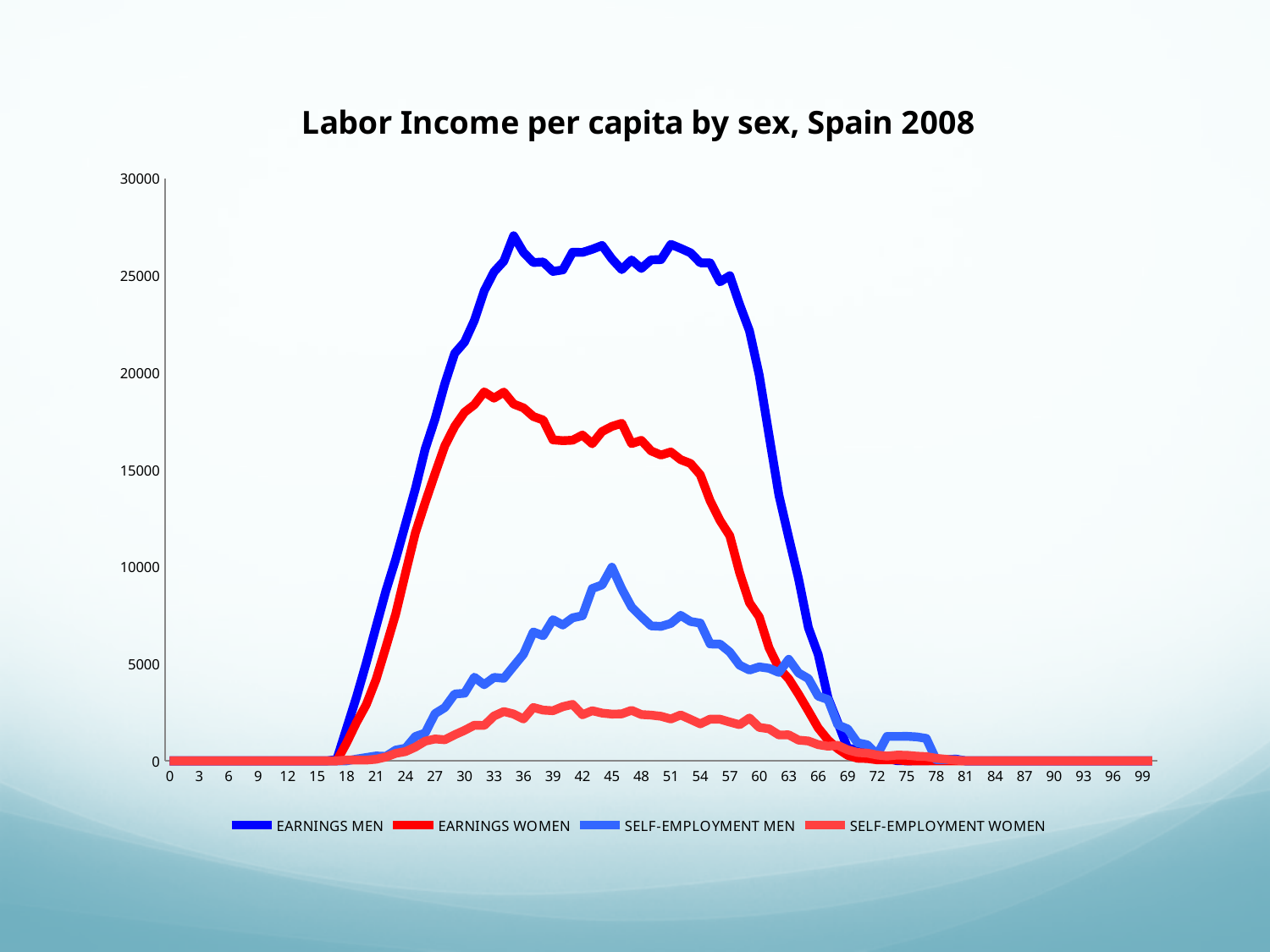
Is the value for SELF-EMPLOYMENT MEN at age 45 greater or less than 5000? greater What kind of chart is shown on the slide? line chart Do the values for EARNINGS WOMEN rise or fall between ages 18 and 30? rise Which series reaches the highest value on the chart? EARNINGS MEN How many series does the legend list? 4 Is the value for SELF-EMPLOYMENT WOMEN at age 42 greater or less than 5000? less Is the value for EARNINGS WOMEN at age 33 greater or less than 20000? less Do the values for EARNINGS MEN rise or fall between ages 60 and 69? fall Which series stays lowest across the working ages? SELF-EMPLOYMENT WOMEN What is the title of the chart? Labor Income per capita by sex, Spain 2008 At age 45, which is larger: EARNINGS MEN or EARNINGS WOMEN? EARNINGS MEN